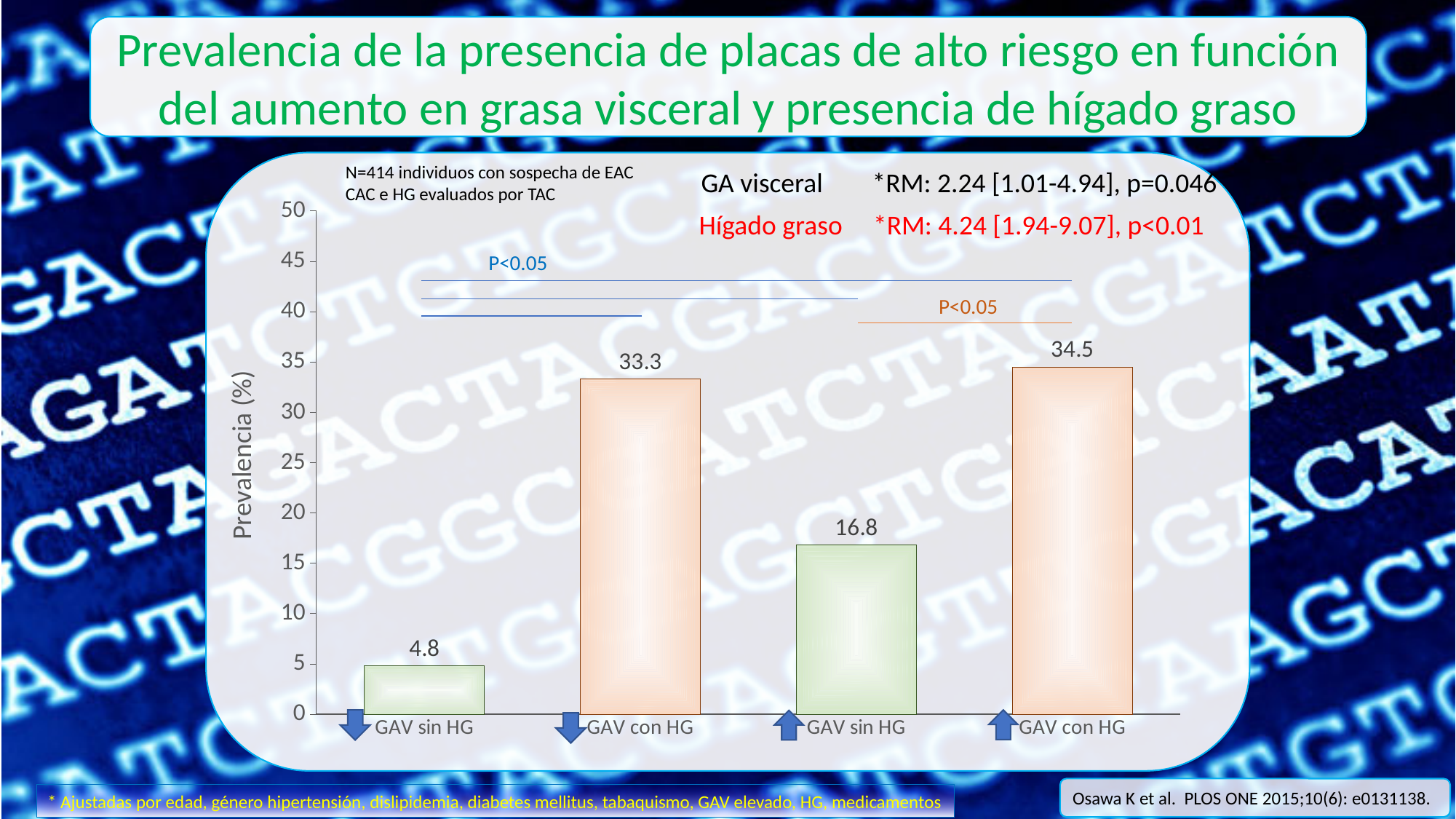
What is the prevalence value shown for the second bar, GAV con HG with the downward arrow? 33.3 Which bar has the lowest prevalence? GAV sin HG (downward arrow), 4.8 What is the label of the vertical axis of the chart? Prevalencia (%) What is the difference in prevalence between the two GAV sin HG bars (upward arrow minus downward arrow)? 12 What type of chart is shown on the slide? Bar chart How many bars are plotted in the chart? 4 What is the difference in prevalence between the two GAV con HG bars (upward arrow minus downward arrow)? 1.2 Which bar has the highest prevalence? GAV con HG (upward arrow), 34.5 Which is larger: the prevalence for GAV con HG with the downward arrow or GAV sin HG with the upward arrow? GAV con HG with the downward arrow What is the prevalence value shown for the third bar, GAV sin HG with the upward arrow? 16.8 What is the prevalence value shown for the first bar, GAV sin HG with the downward arrow? 4.8 What is the prevalence value shown for the fourth bar, GAV con HG with the upward arrow? 34.5